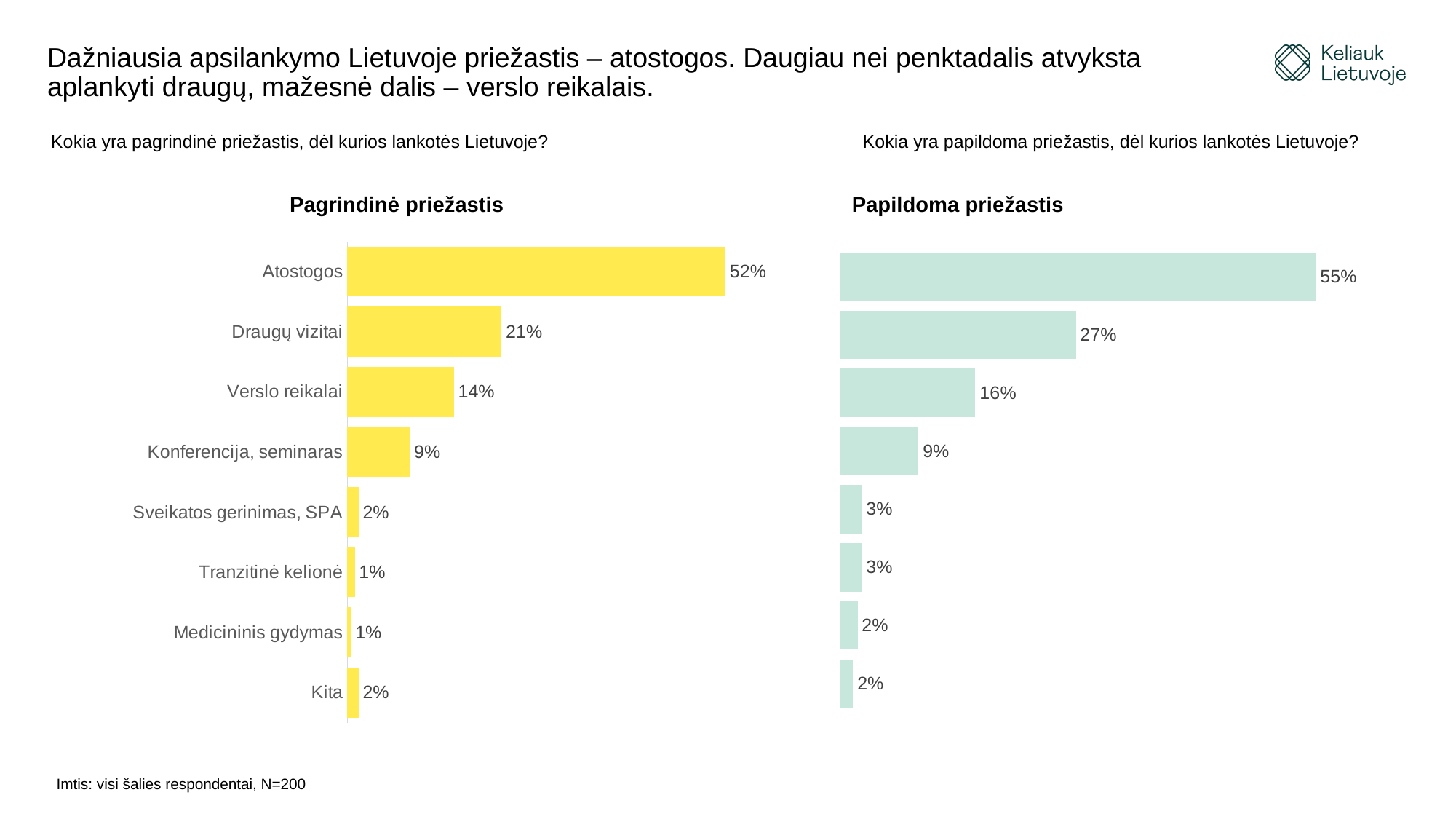
In the 'Pagrindinė priežastis' chart, what is the value for Verslo reikalai? 14% In the 'Pagrindinė priežastis' chart, which category has the highest value? Atostogos How many categories are shown in the 'Pagrindinė priežastis' chart? 8 In the 'Pagrindinė priežastis' chart, what is the value for Atostogos? 52% What colour are the bars in the 'Pagrindinė priežastis' chart? Yellow In the 'Papildoma priežastis' chart, what is the value of the second bar from the top? 27% Which is larger: the top bar of the 'Papildoma priežastis' chart or the Atostogos bar of the 'Pagrindinė priežastis' chart? The top bar of the 'Papildoma priežastis' chart In the 'Papildoma priežastis' chart, what is the value of the top bar? 55% In the 'Papildoma priežastis' chart, what is the difference between the top bar and the second bar? 28% In the 'Pagrindinė priežastis' chart, which is larger: Konferencija, seminaras or Sveikatos gerinimas, SPA? Konferencija, seminaras What kind of chart is the 'Pagrindinė priežastis' chart? Bar chart In the 'Pagrindinė priežastis' chart, what is the difference between Atostogos and Draugų vizitai? 31%